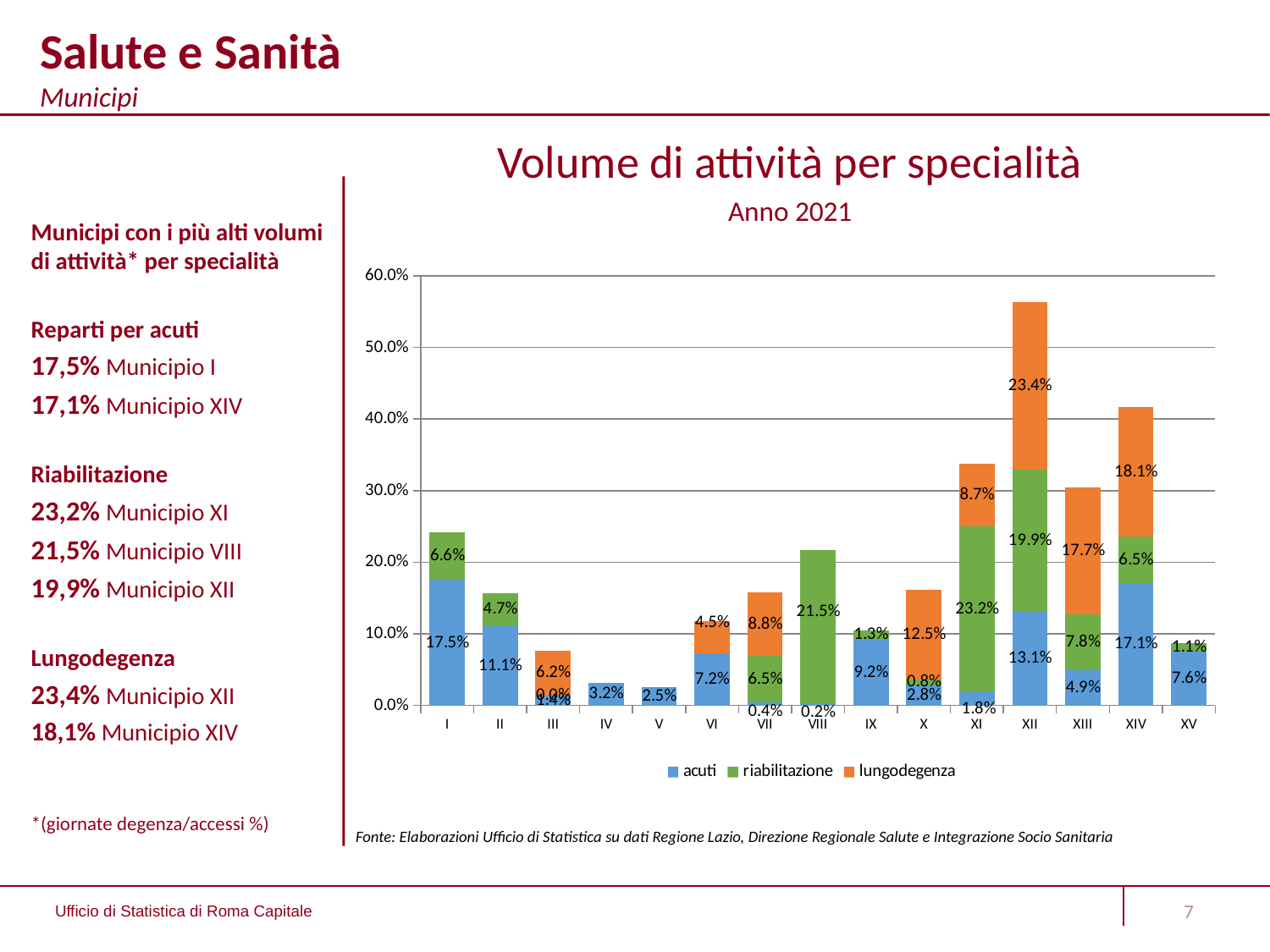
What is the difference between the acuti values for Municipio I and Municipio XIV? 0.4% Which municipio has the highest riabilitazione value? XI Which is larger, the riabilitazione value for Municipio XI or for Municipio XII? Municipio XI Which municipio has the highest lungodegenza value? XII How many series does the legend list? 3 What kind of chart is shown? Stacked bar chart What is the value of the riabilitazione series for Municipio VIII? 21.5% What is the value of the acuti series for Municipio I? 17.5% What is the total of the stacked bar for Municipio XIV? 41.7% Is the total stacked bar for Municipio XII greater or less than 50.0%? greater How many municipi are shown on the x axis? 15 What is the value of the lungodegenza series for Municipio XII? 23.4%